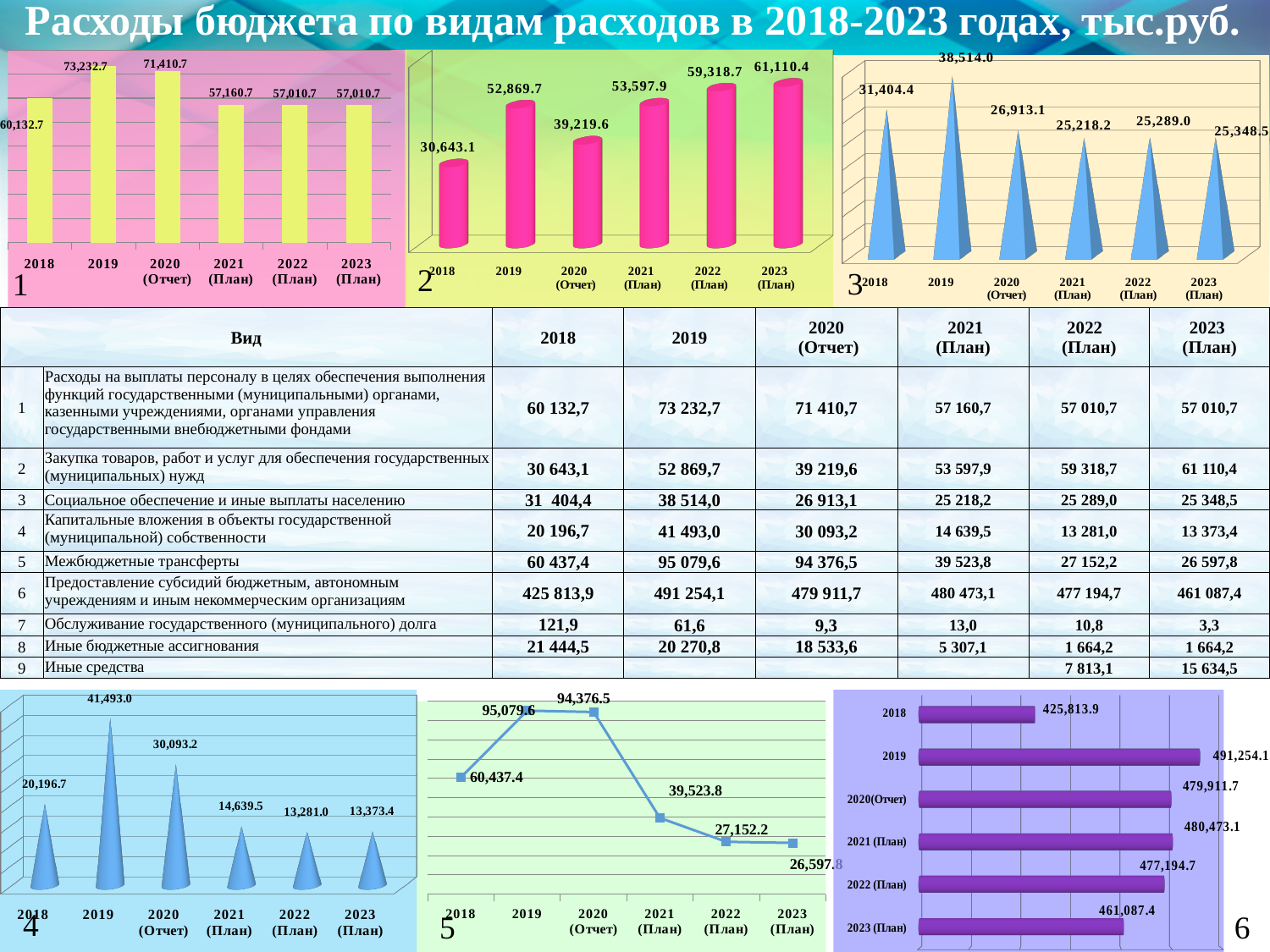
What type of chart is chart 5 (bottom-middle)? line chart In chart 4 (bottom-left, blue cones), do the values rise or fall from 2019 to 2022 (План)? fall In chart 5 (bottom-middle, line chart), what is the difference between the 2019 value and the 2023 (План) value? 68,481.8 How many years are plotted in chart 2 (top-middle, pink cylinders)? 6 In chart 3 (top-right, blue cones), which year has the highest value? 2019 In chart 2 (top-middle, pink cylinders), which year has the highest value? 2023 (План) In chart 2 (top-middle, pink cylinders), what is the difference between the 2023 (План) value and the 2018 value? 30,467.3 In chart 4 (bottom-left, blue cones), what is the value for 2020 (Отчет)? 30,093.2 In chart 1 (top-left, yellow bars), which is larger: the value for 2018 or the value for 2021 (План)? 2018 What type of chart is chart 6 (bottom-right, purple)? bar chart In chart 6 (bottom-right, purple bars), which year has the highest value? 2019 In chart 1 (top-left, yellow bars), what is the value for 2019? 73,232.7